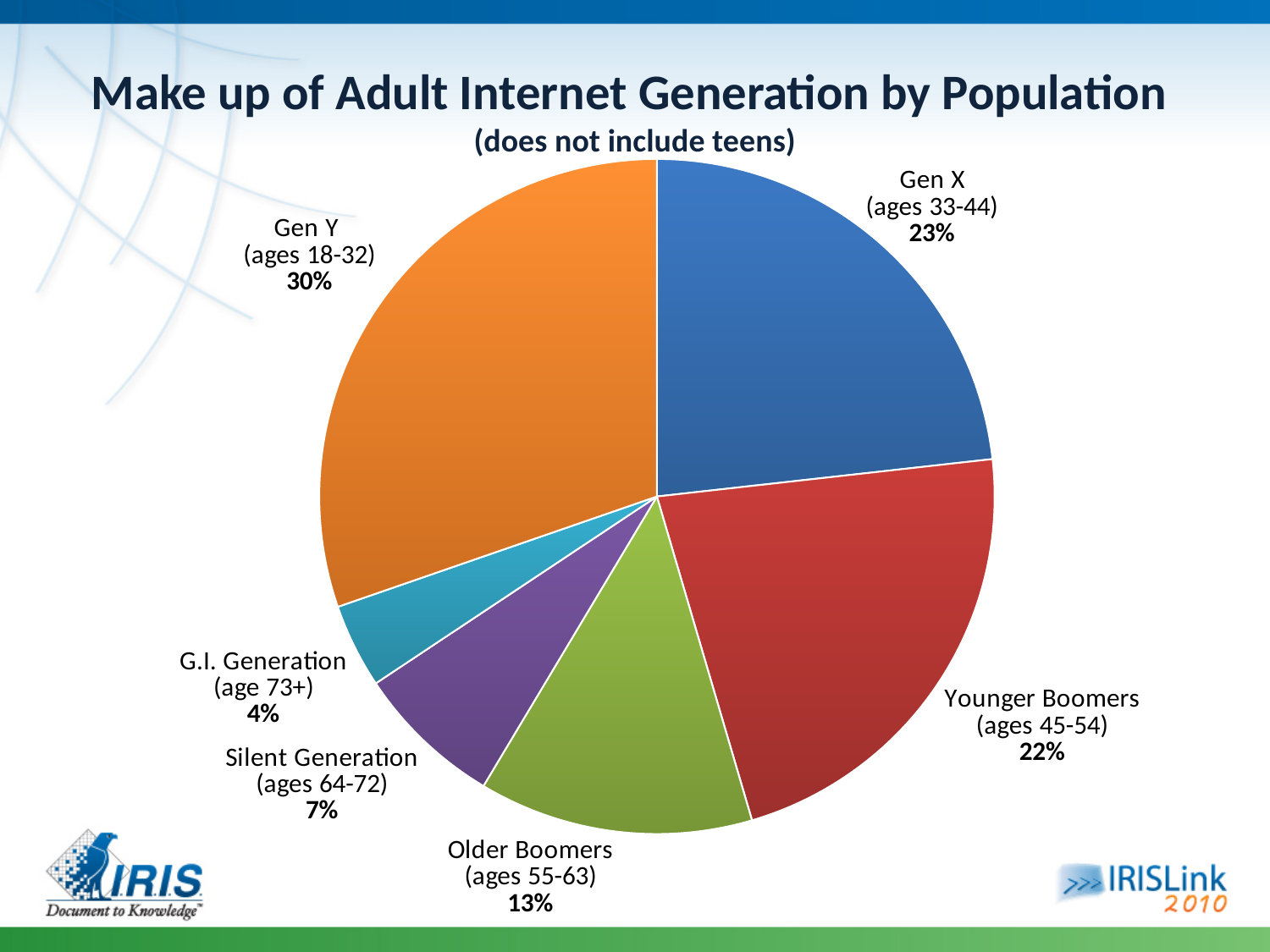
What is the title of the chart? Make up of Adult Internet Generation by Population What share of the adult internet generation is Gen Y (ages 18-32)? 30% What percentage is shown for the G.I. Generation (age 73+)? 4% How many generation categories are shown in the pie chart? 6 What is the difference in percentage points between Gen Y and Gen X? 7 Which generation has the smallest slice of the pie? G.I. Generation (age 73+) What percentage is shown for Gen X (ages 33-44)? 23% Which generation has the largest slice of the pie? Gen Y (ages 18-32) What kind of chart is shown on the slide? pie chart What percentage is shown for Older Boomers (ages 55-63)? 13% What is the combined share of the Silent Generation and the G.I. Generation? 11% Which is larger, the share for Younger Boomers or the share for Older Boomers? Younger Boomers